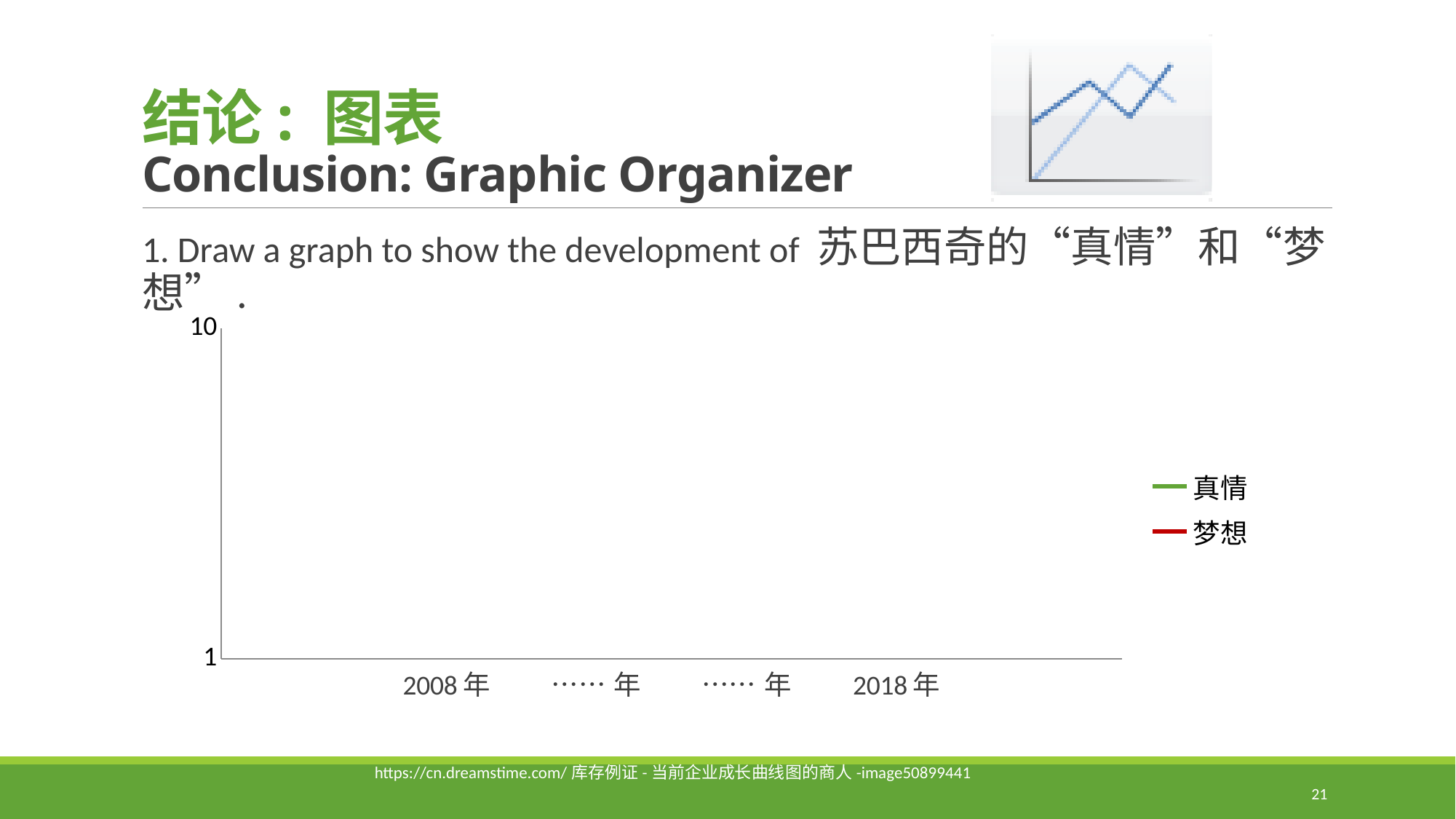
What is the lowest value shown on the chart's y axis? 1 How many categories are labelled along the x axis of the chart? 4 What is the highest value shown on the chart's y axis? 10 What colour is the legend marker for the series 梦想? Red How many series does the chart's legend list? 2 What is the last category label on the chart's x axis? 2018 年 What is the first category label on the chart's x axis? 2008 年 What are the two series named in the chart's legend? 真情 and 梦想